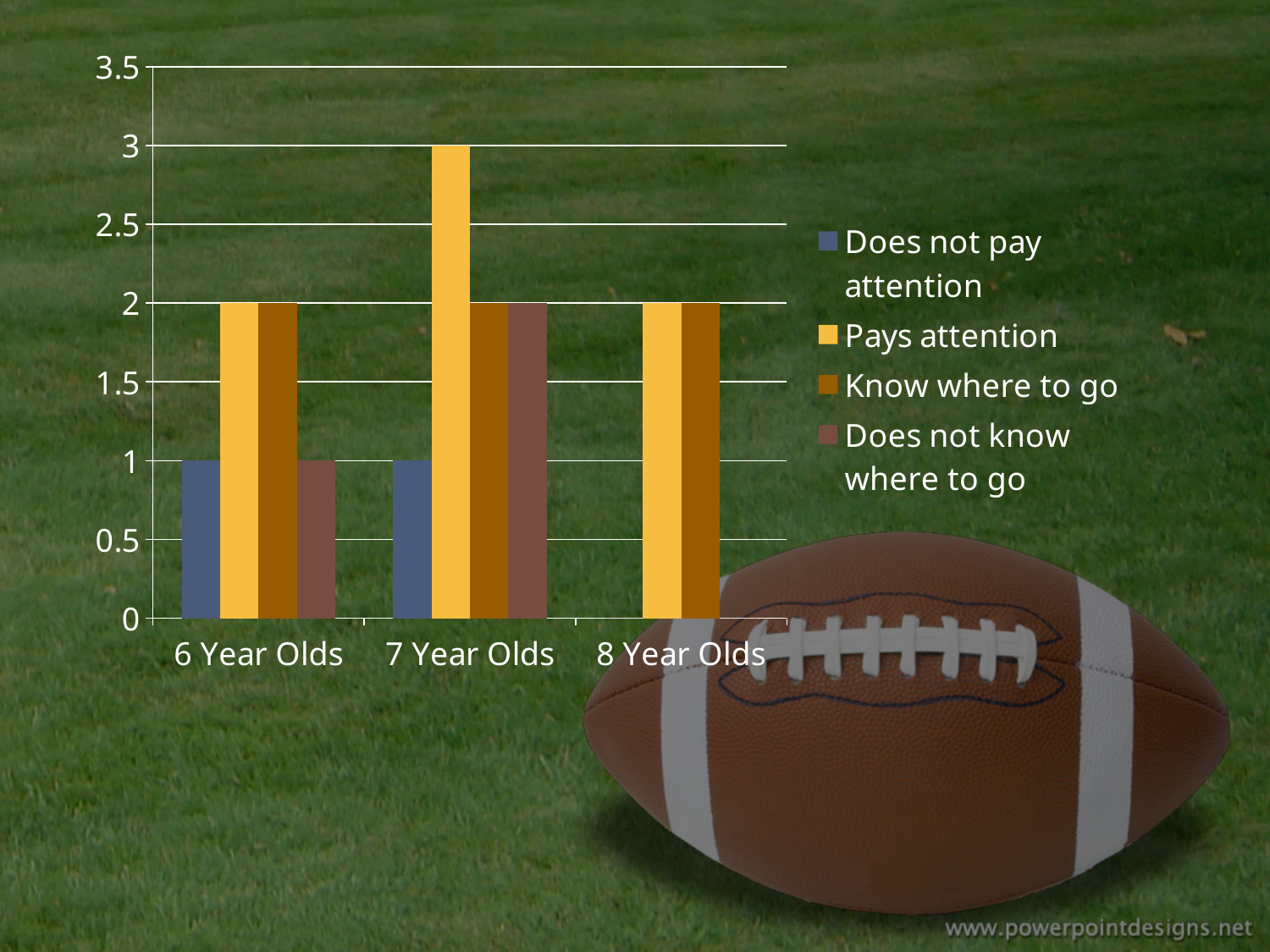
What kind of chart is shown on the slide? bar chart What is the value for Does not pay attention for 6 Year Olds? 1 What is the value for Know where to go for 8 Year Olds? 2 How many age-group categories are shown on the x axis? 3 What is the difference between Pays attention and Does not pay attention for 7 Year Olds? 2 Which legend entry is shown in blue? Does not pay attention Which is larger for 6 Year Olds: Pays attention or Does not know where to go? Pays attention What is the value for Pays attention for 7 Year Olds? 3 Which age group has the highest value for Pays attention? 7 Year Olds How many series does the legend list? 4 What is the value for Does not know where to go for 7 Year Olds? 2 Which age group has the lowest value for Does not know where to go? 8 Year Olds